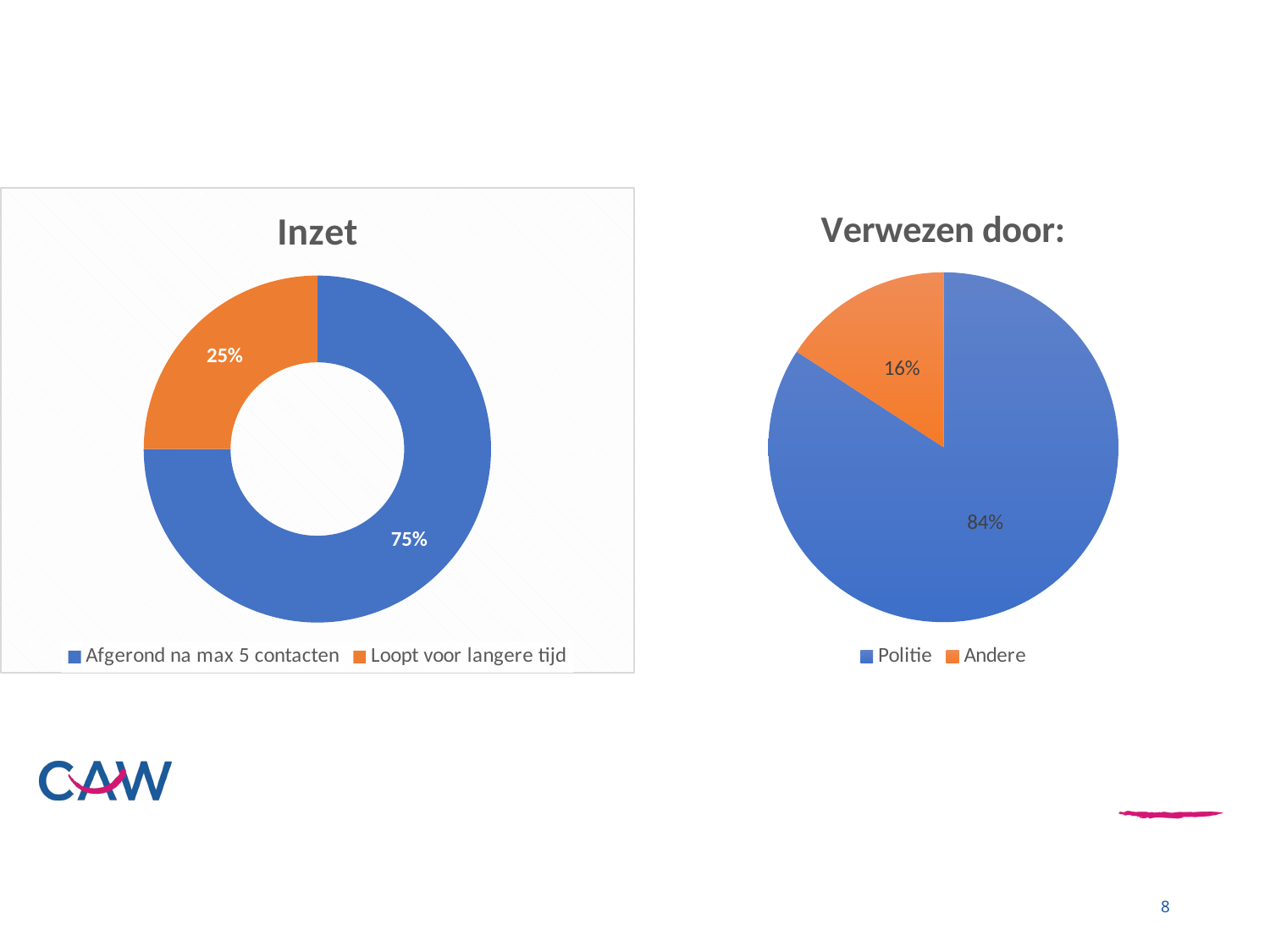
In the 'Verwezen door:' chart, which category has the smallest share? Andere In the 'Verwezen door:' chart, what share is labelled for 'Andere'? 16% In the 'Inzet' chart, which category has the largest share? Afgerond na max 5 contacten In the 'Inzet' chart, what share is labelled for 'Loopt voor langere tijd'? 25% In the 'Verwezen door:' chart, what is the difference in percentage points between 'Politie' and 'Andere'? 68 What is the title of the chart on the left side of the slide? Inzet In the 'Inzet' chart, what share is labelled for 'Afgerond na max 5 contacten'? 75% In the 'Verwezen door:' chart, which is larger: 'Politie' or 'Andere'? Politie What kind of chart is the 'Verwezen door:' chart? Pie chart In the 'Inzet' chart, what is the difference in percentage points between 'Afgerond na max 5 contacten' and 'Loopt voor langere tijd'? 50 How many categories does the legend of the 'Inzet' chart list? 2